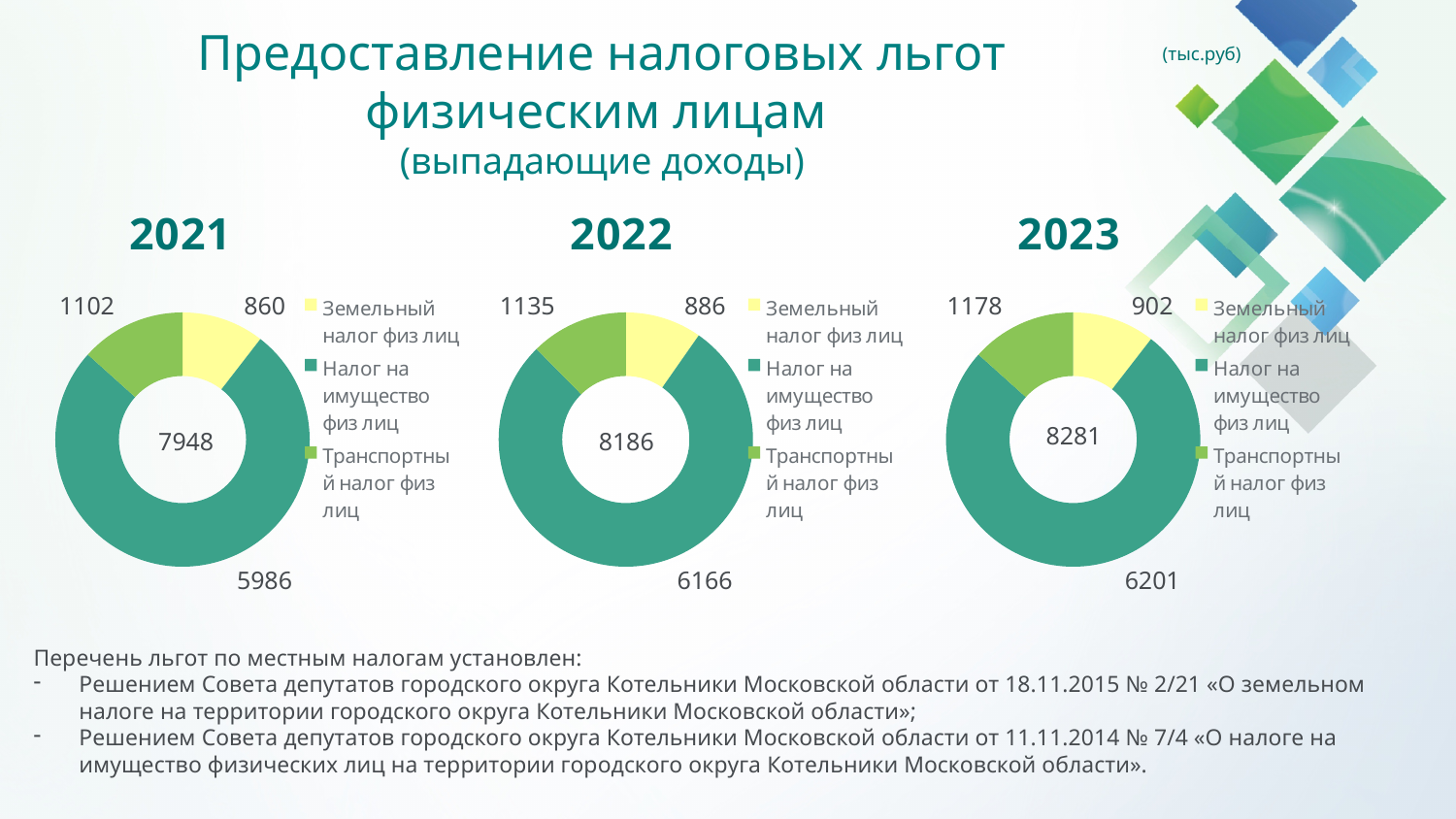
In the 2021 chart, which category has the smallest value? Земельный налог физ лиц How many entries does the legend of the 2021 chart list? 3 In the 2023 chart, what is the difference between Транспортный налог физ лиц and Земельный налог физ лиц? 276 In the 2023 chart, what is the value for Транспортный налог физ лиц? 1178 What total is shown in the centre of the 2022 chart? 8186 Across the 2021, 2022 and 2023 charts, does the value for Транспортный налог физ лиц rise or fall? Rise In the 2023 chart, which category has the largest value? Налог на имущество физ лиц In the 2022 chart, which is larger: Транспортный налог физ лиц or Земельный налог физ лиц? Транспортный налог физ лиц How many categories does each chart show? 3 What kind of chart is used for the 2021 data? Doughnut chart In the 2021 chart, what is the value for Налог на имущество физ лиц? 5986 In the 2022 chart, what is the value for Земельный налог физ лиц? 886